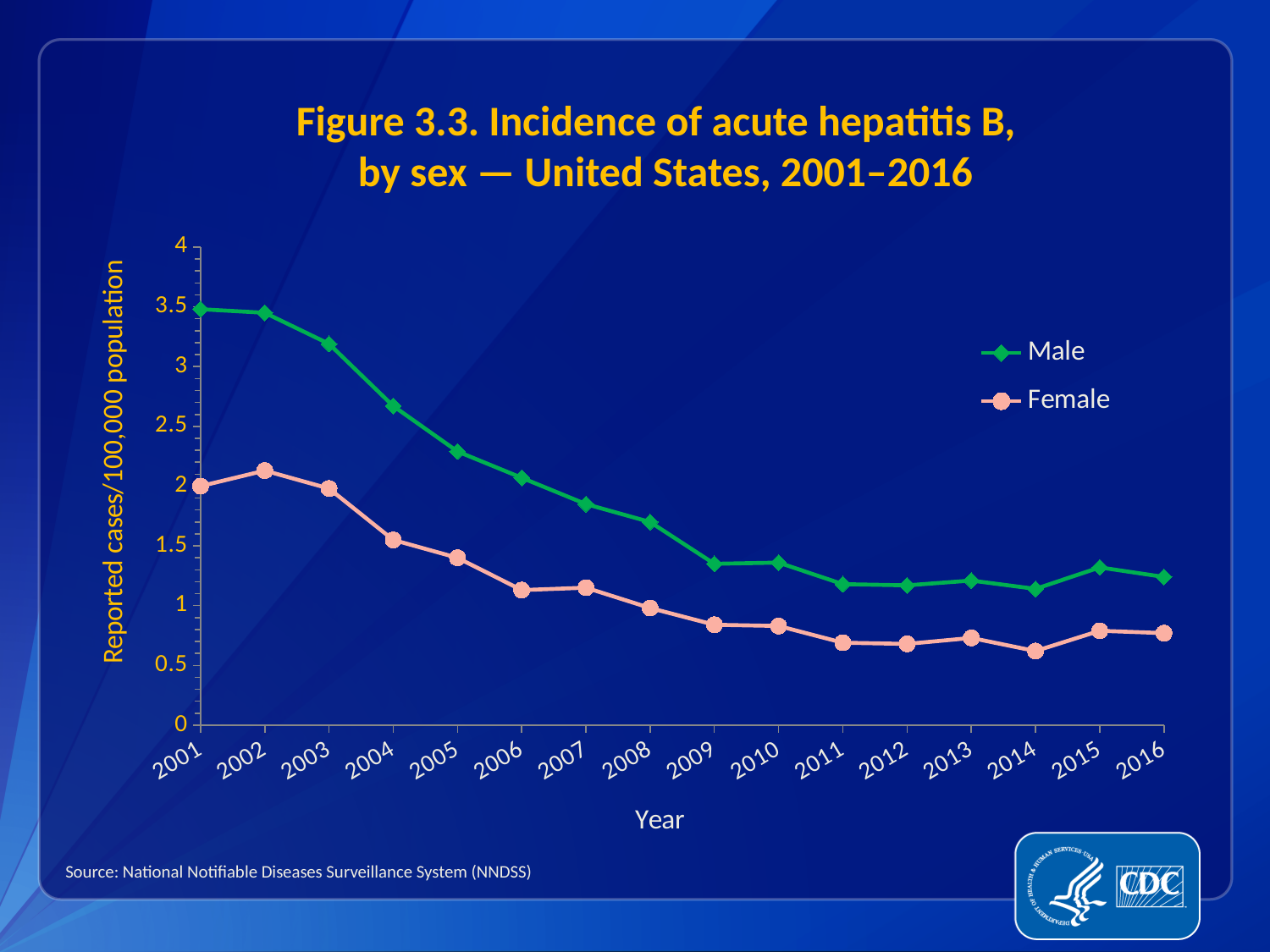
Is the Female value for 2011 greater or less than 1? less Is the Male value for 2016 greater or less than 1? greater Is the Male value for 2009 greater or less than 1.5? less How many series does the legend list? 2 In which year is the Female incidence rate highest? 2002 Does the Male incidence rate generally rise or fall from 2001 to 2016? fall What kind of chart is shown on the slide? line chart In 2005, which series has the higher incidence rate, Male or Female? Male How many years are plotted along the x axis? 16 In which year is the Female incidence rate lowest? 2014 What is the label of the y axis? Reported cases/100,000 population